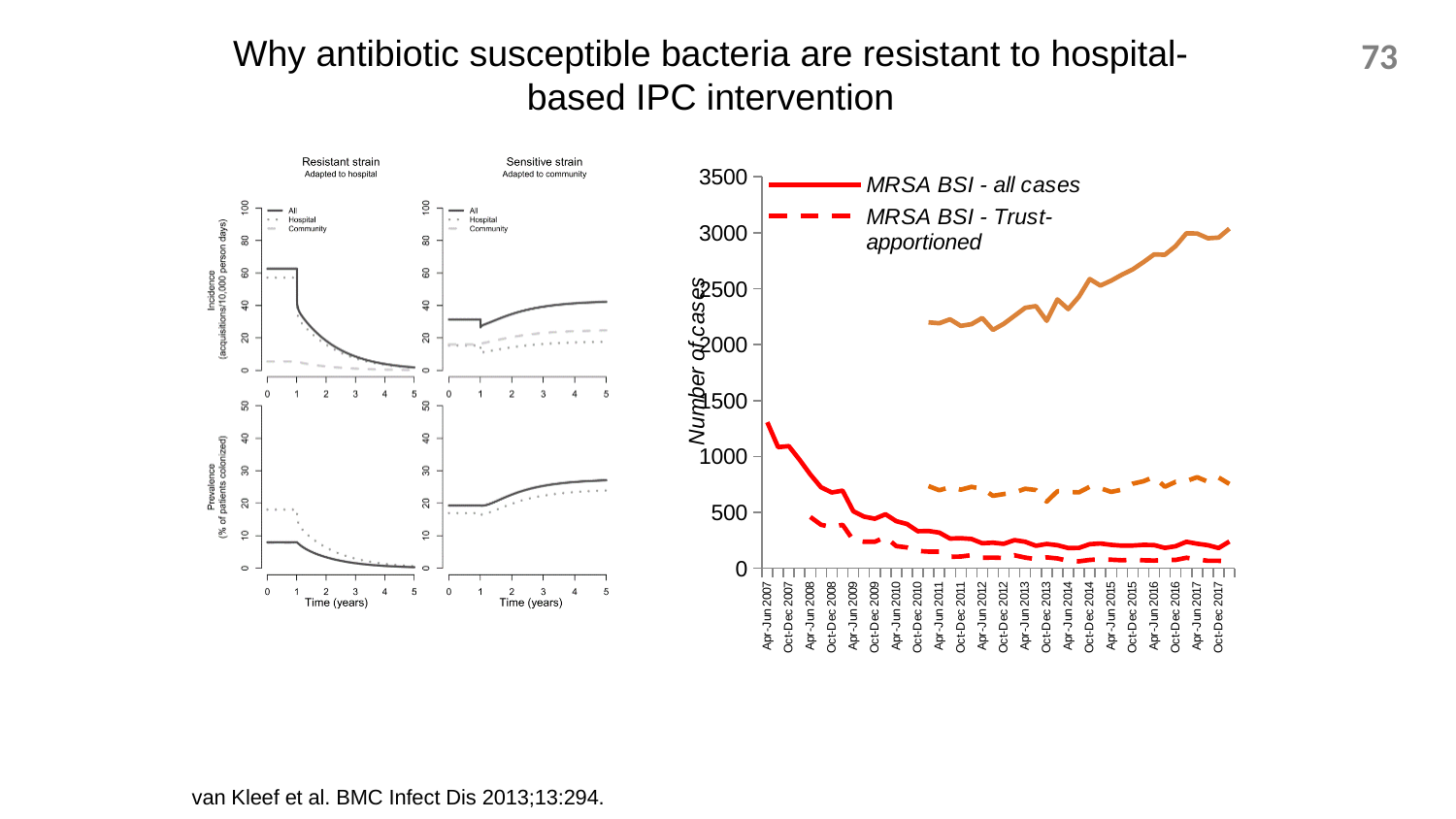
What kind of chart is the chart on the right of the slide? line chart In the chart on the right, is the value of MRSA BSI - Trust-apportioned at Oct-Dec 2017 greater or less than 500? less In the chart on the right, is the value of MRSA BSI - all cases at Apr-Jun 2007 greater or less than 1000? greater In the chart on the right, is the value of MRSA BSI - all cases at Oct-Dec 2017 greater or less than 500? less In the left-hand figure, what is the title of the horizontal axis? Time (years) In the chart on the right, how many series does the legend list? 2 In the chart on the right, does the solid orange line rise or fall between Apr-Jun 2011 and Oct-Dec 2017? rise In the chart on the right, does the MRSA BSI - all cases line rise or fall from Apr-Jun 2007 to Oct-Dec 2017? fall In the left-hand figure, how many series does the legend in the Resistant strain incidence panel list? 3 In the chart on the right, at Oct-Dec 2017, which is larger: MRSA BSI - all cases or MRSA BSI - Trust-apportioned? MRSA BSI - all cases In the chart on the right, what is the title of the vertical axis? Number of cases